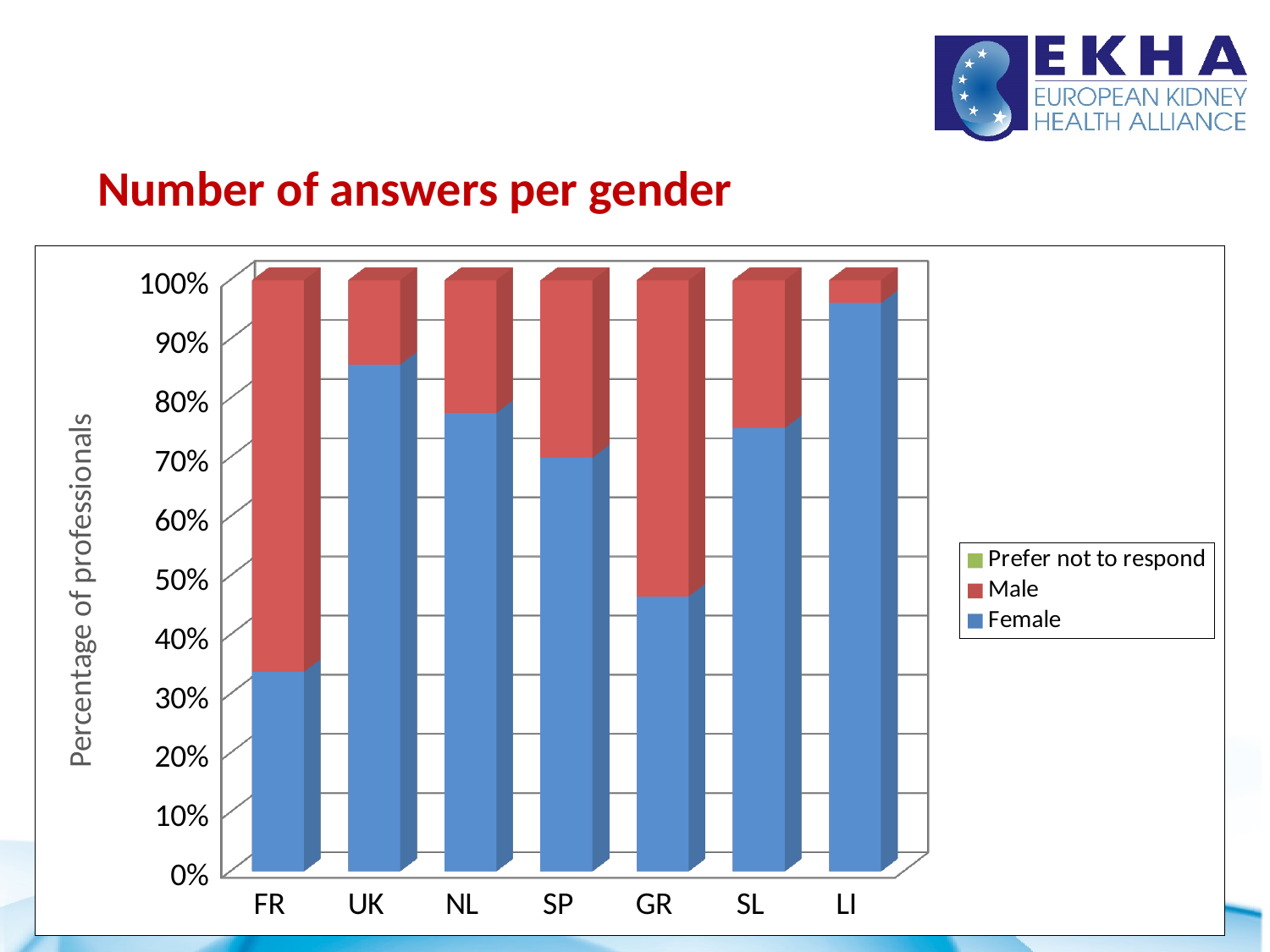
What is the title of the chart on the slide? Number of answers per gender Which country has a larger Female share, NL or SP? NL Is the Female share for GR greater or less than 50%? less Is the Female share for FR greater or less than 40%? less Which country has the largest share of Male professionals? FR Is the Female share for UK greater or less than 80%? greater How many series does the chart's legend list? 3 What is the label of the vertical axis? Percentage of professionals What kind of chart is shown on the slide? stacked bar chart Which country has the highest share of Female professionals? LI Which country has the lowest share of Female professionals? FR How many countries are shown on the x axis of the chart? 7